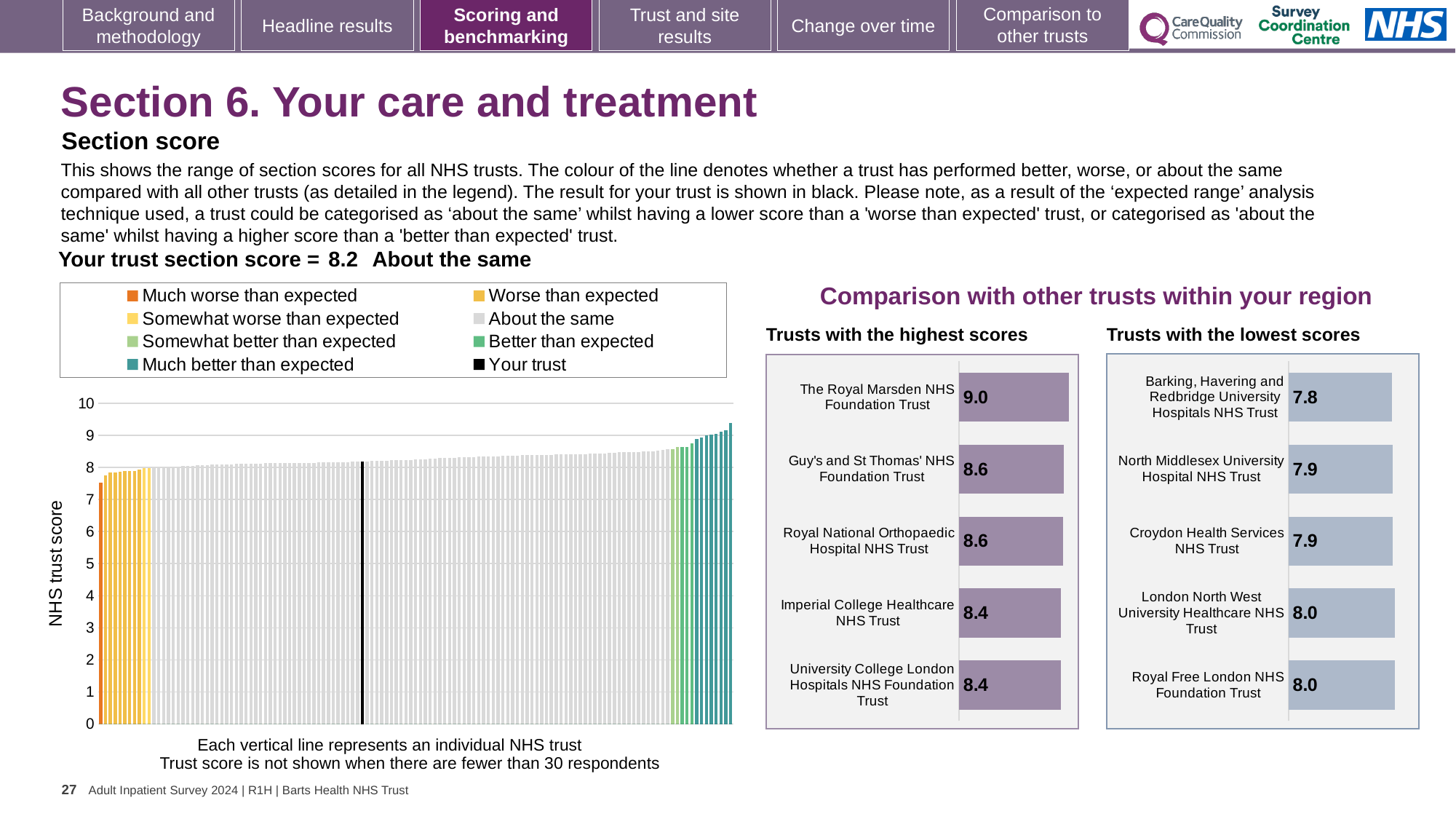
In the 'Trusts with the highest scores' chart, what is the score for Imperial College Healthcare NHS Trust? 8.4 In the 'Trusts with the lowest scores' chart, what is the score for Barking, Havering and Redbridge University Hospitals NHS Trust? 7.8 In the 'Trusts with the highest scores' chart, what is the score for The Royal Marsden NHS Foundation Trust? 9.0 In the 'Trusts with the highest scores' chart, which trust has the highest score? The Royal Marsden NHS Foundation Trust In the 'Trusts with the lowest scores' chart, what is the score for Croydon Health Services NHS Trust? 7.9 What kind of chart is the main 'NHS trust score' chart on the left? Bar chart In the 'Trusts with the lowest scores' chart, which has the larger score: North Middlesex University Hospital NHS Trust or Royal Free London NHS Foundation Trust? Royal Free London NHS Foundation Trust In the main 'NHS trust score' chart, do the trust scores rise or fall from left to right? Rise How many entries does the legend of the main 'NHS trust score' chart list? 8 In the 'Trusts with the lowest scores' chart, which trust has the lowest score? Barking, Havering and Redbridge University Hospitals NHS Trust How many trusts are shown in the 'Trusts with the lowest scores' chart? 5 In the 'Trusts with the highest scores' chart, what is the difference between the scores of The Royal Marsden NHS Foundation Trust and Imperial College Healthcare NHS Trust? 0.6